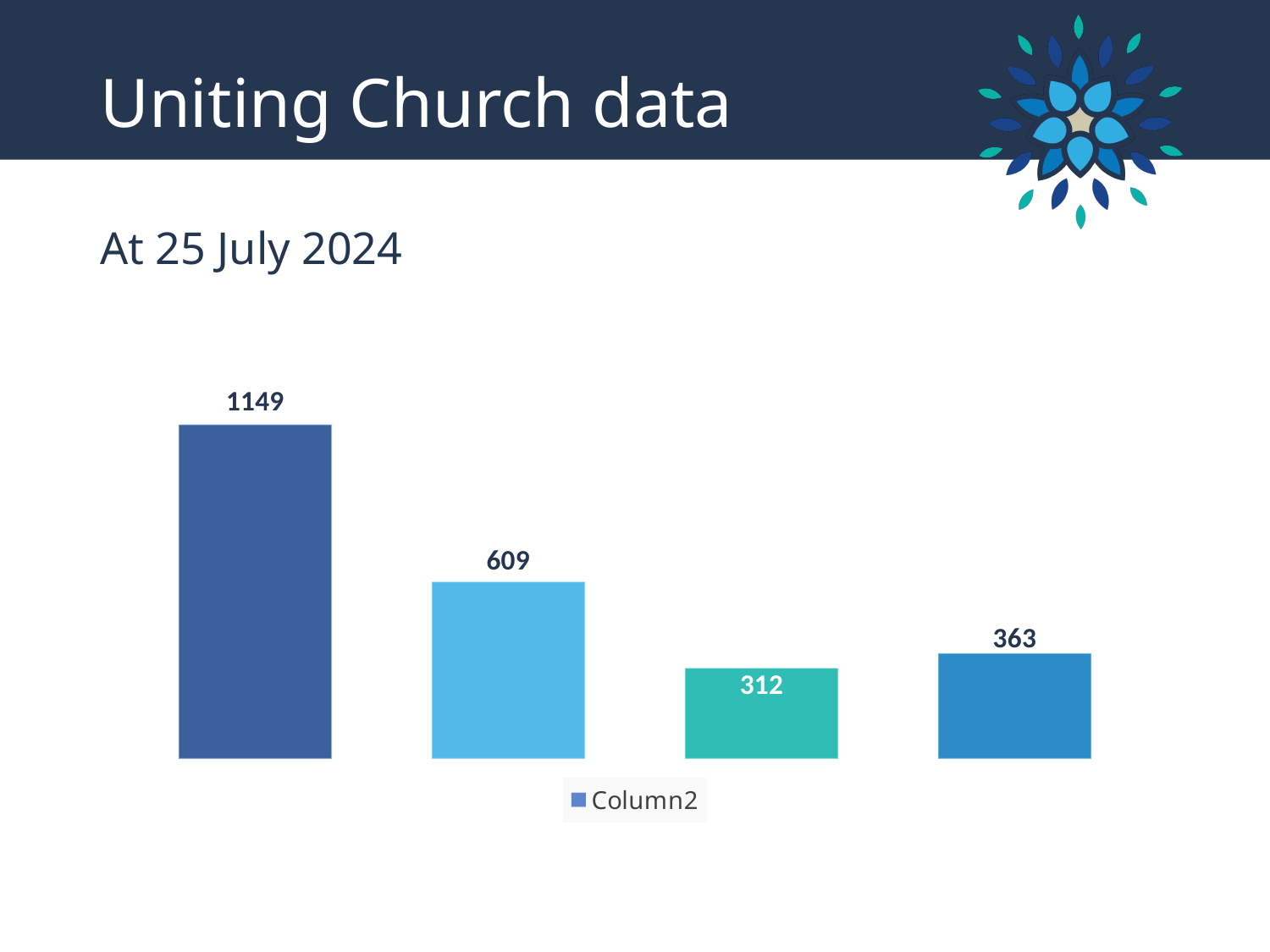
How many series does the chart legend list? 1 What is the series name shown in the chart legend? Column2 What kind of chart is shown on the slide? bar chart What is the value shown on the first (leftmost) bar? 1149 How many bars are plotted in the chart? 4 What is the value shown on the third bar from the left? 312 What is the value shown on the fourth (rightmost) bar? 363 What is the highest value shown in the chart? 1149 What is the lowest value shown in the chart? 312 Which is larger, the value of the third bar or the value of the fourth bar? the fourth bar (363) What is the difference between the first bar's value and the second bar's value? 540 What is the value shown on the second bar from the left? 609